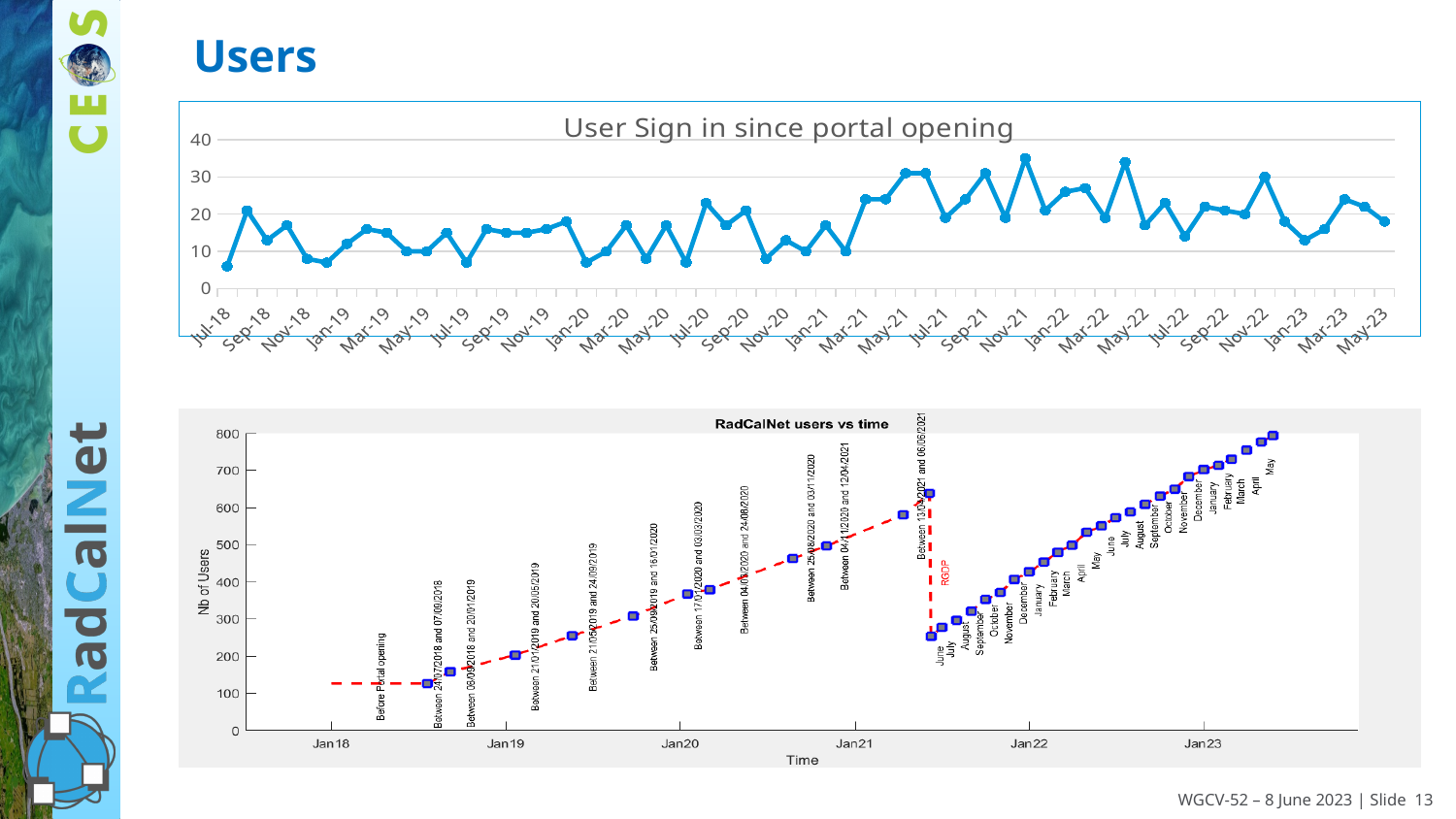
What kind of chart is the 'User Sign in since portal opening' chart? line chart In the 'RadCalNet users vs time' chart, is the value for May 2023 (the last point) greater or less than 700? greater In the 'User Sign in since portal opening' chart, is the value for Nov-21 greater or less than 30? greater What is the title of the lower chart on the slide? RadCalNet users vs time In the 'RadCalNet users vs time' chart, do the values generally rise or fall from Jan22 to Jan23? rise In the 'User Sign in since portal opening' chart, is the value for Jul-18 greater or less than 10? less In the 'User Sign in since portal opening' chart, what is the highest value shown on the vertical axis? 40 In the 'RadCalNet users vs time' chart, what is the label of the vertical axis? Nb of Users